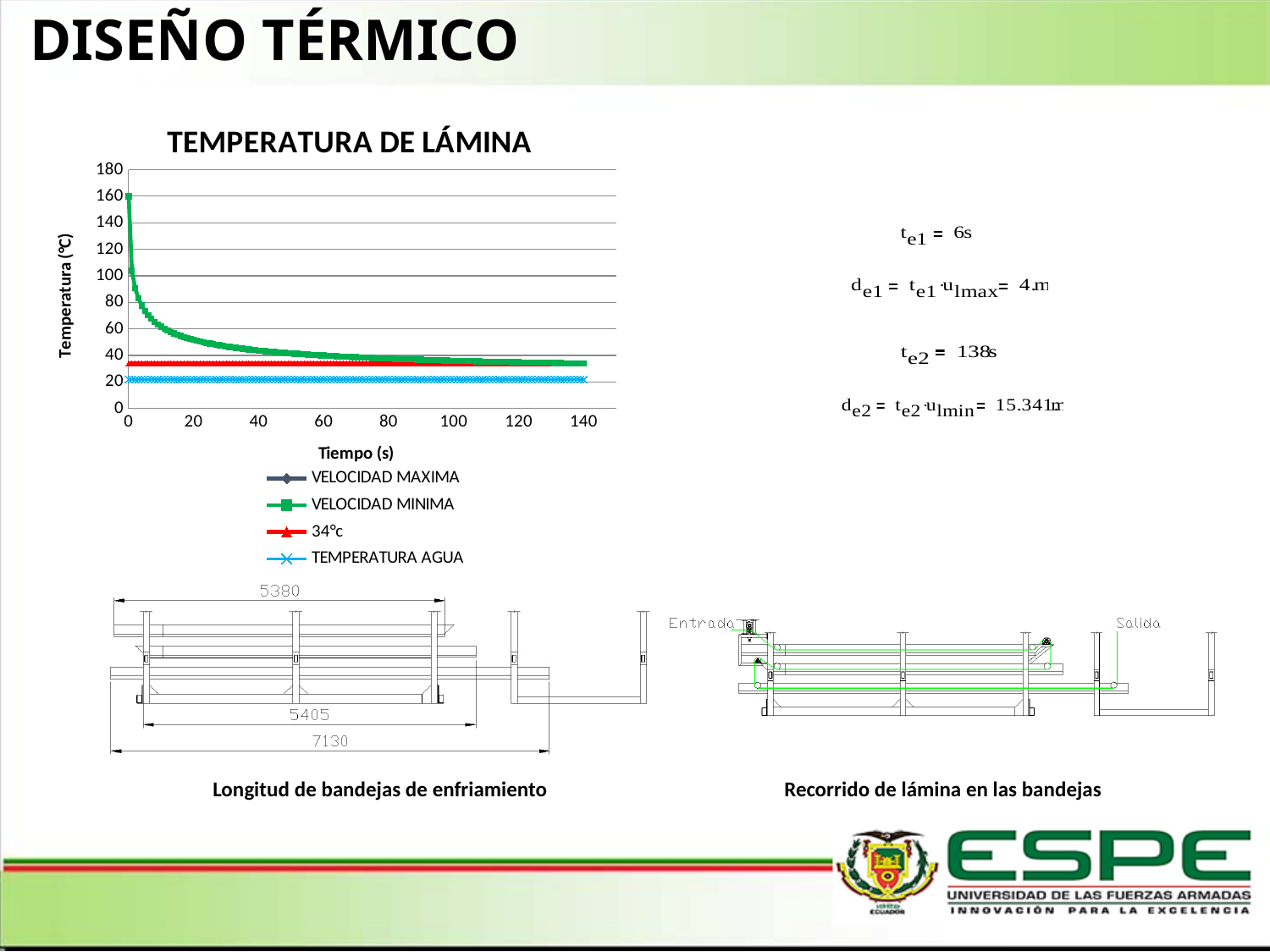
In the "TEMPERATURA DE LÁMINA" chart, which is larger at time 20: VELOCIDAD MINIMA or TEMPERATURA AGUA? VELOCIDAD MINIMA How many series does the legend of the "TEMPERATURA DE LÁMINA" chart list? 4 In the "TEMPERATURA DE LÁMINA" chart, is the VELOCIDAD MINIMA value at time 0 greater or less than 140? greater What is the highest tick value shown on the y-axis of the "TEMPERATURA DE LÁMINA" chart? 180 In the "TEMPERATURA DE LÁMINA" chart, does the VELOCIDAD MINIMA series rise or fall as time increases? fall In the "TEMPERATURA DE LÁMINA" chart, is the TEMPERATURA AGUA value at time 60 greater or less than 40? less What is the title of the chart on the slide? TEMPERATURA DE LÁMINA In the "TEMPERATURA DE LÁMINA" chart, which series has the lowest values across the whole time range? TEMPERATURA AGUA In the "TEMPERATURA DE LÁMINA" chart, is the VELOCIDAD MINIMA value at time 100 greater or less than 60? less What kind of chart is "TEMPERATURA DE LÁMINA"? line chart What is the x-axis title of the "TEMPERATURA DE LÁMINA" chart? Tiempo (s)